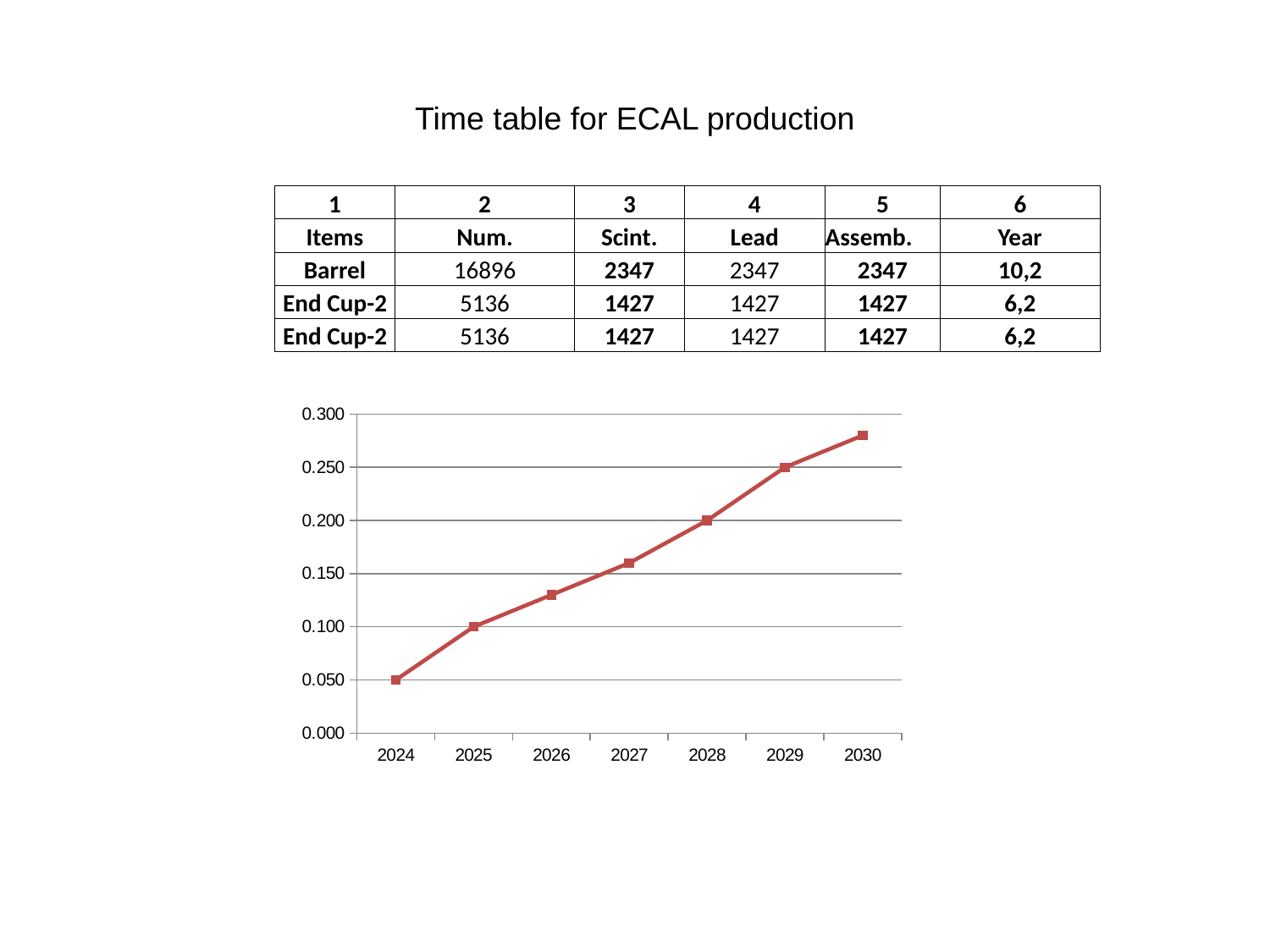
Do the values on the line chart rise or fall from 2024 to 2030? rise Which year has the highest value on the line chart? 2030 How many data points are plotted on the line chart? 7 What is the value for 2029 on the line chart? 0.250 Is the value for 2030 on the line chart greater or less than 0.250? greater What is the difference between the values for 2029 and 2024 on the line chart? 0.200 What is the value for 2028 on the line chart? 0.200 What kind of chart is shown on the slide? line chart Is the value for 2026 on the line chart greater or less than 0.150? less Which year has the lowest value on the line chart? 2024 What is the value for 2025 on the line chart? 0.100 What is the value for 2024 on the line chart? 0.050